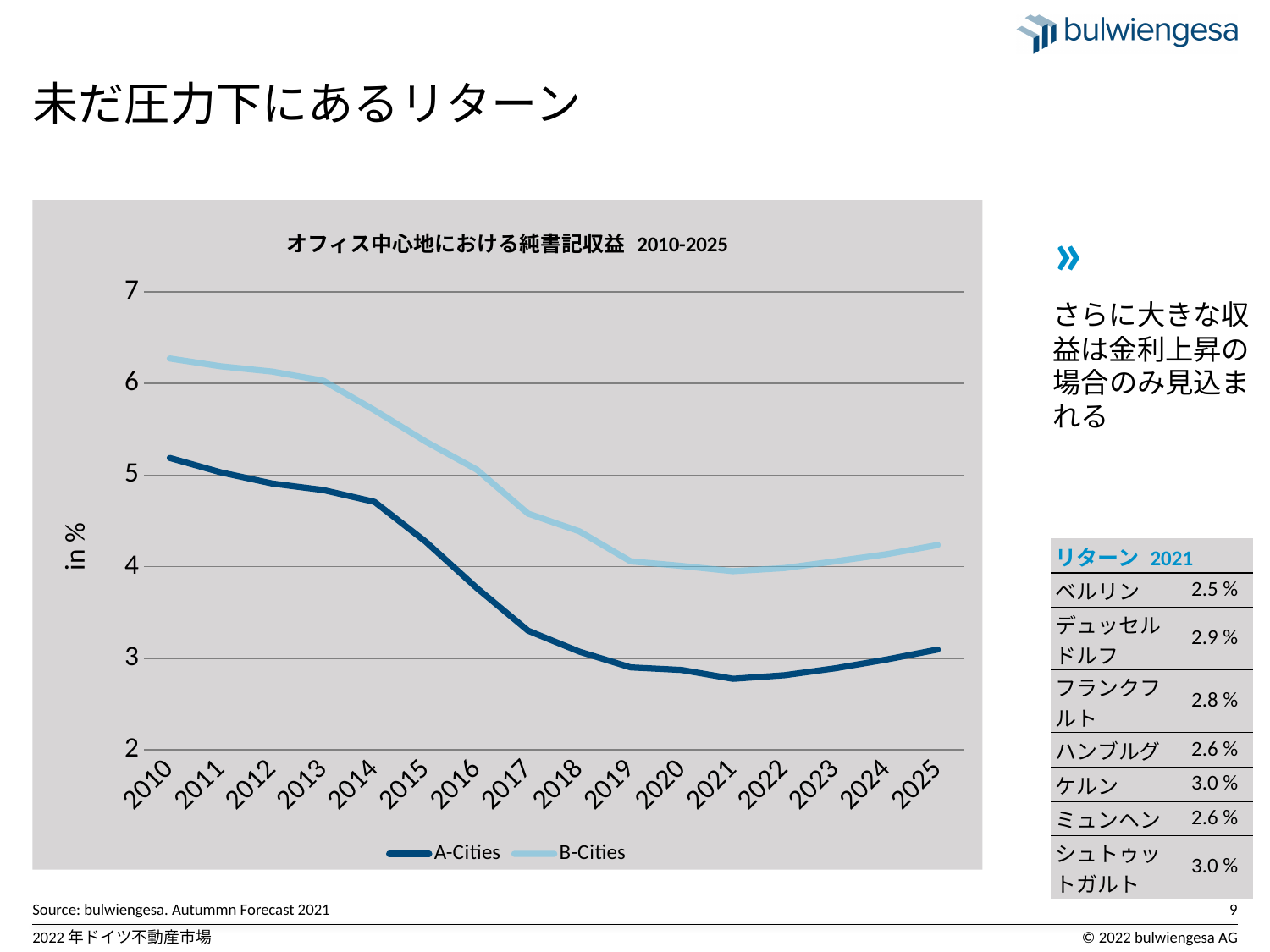
Which series has the larger value in 2015, A-Cities or B-Cities? B-Cities How many years are shown along the x axis of the chart? 16 Which series is drawn in the darker blue line? A-Cities Is the value for B-Cities in 2014 greater or less than 6? less How many series does the chart legend list? 2 Is the value for A-Cities in 2021 greater or less than 3? less Is the value for A-Cities in 2010 greater or less than 5? greater What is the label of the y axis of the chart? in % Does the A-Cities line rise or fall from 2010 to 2021? fall What kind of chart is shown on the slide? line chart